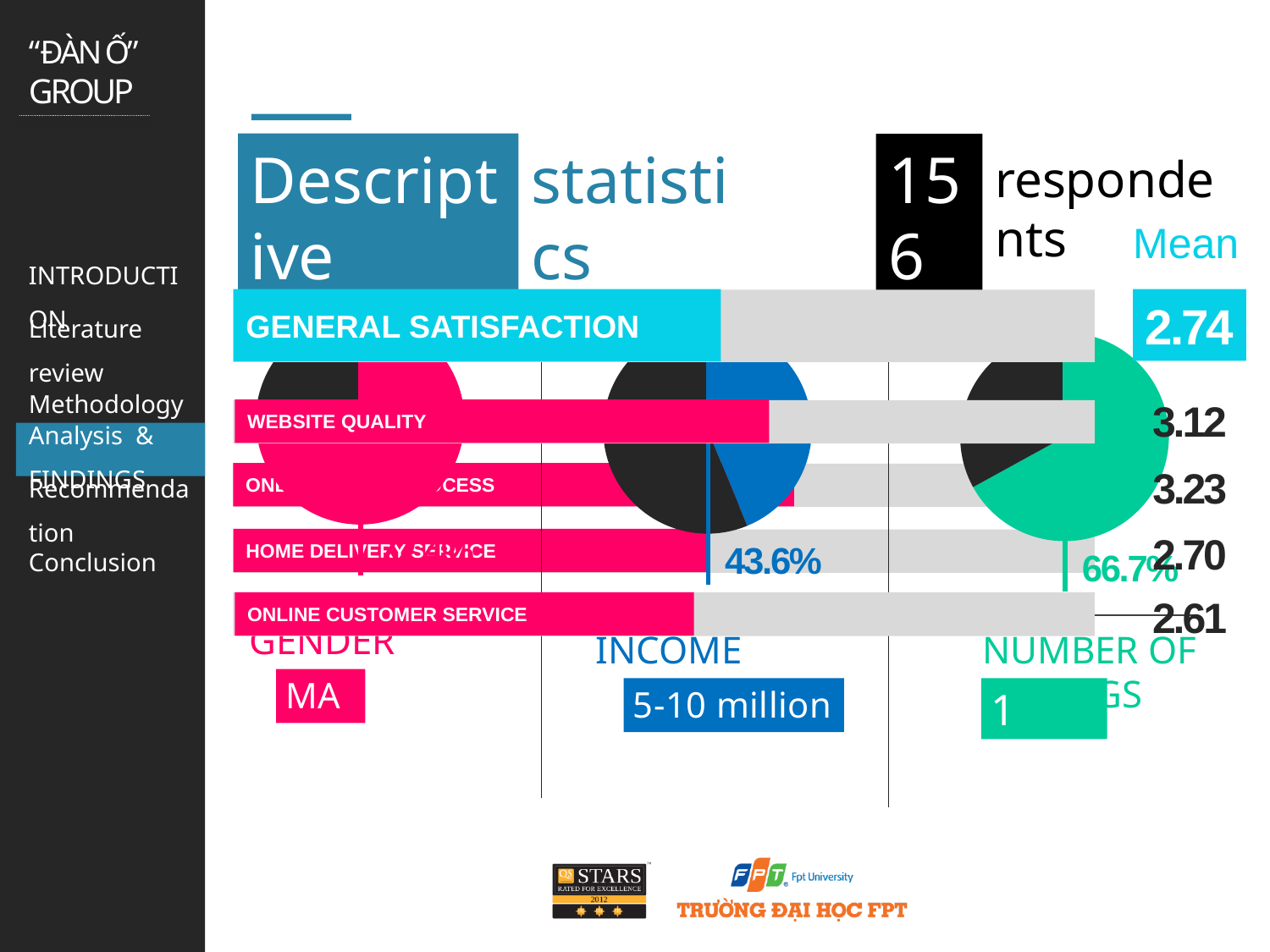
In the bar chart of mean scores, what is the difference between the means for HOME DELIVERY SERVICE and ONLINE CUSTOMER SERVICE? 0.09 How many categories are shown in the bar chart of mean scores? 5 In the bar chart of mean scores, what is the mean for GENERAL SATISFACTION? 2.74 In the bar chart of mean scores, what is the mean for WEBSITE QUALITY? 3.12 What kind of chart is used to show the mean scores? bar chart In the bar chart of mean scores, which category has the lowest mean? ONLINE CUSTOMER SERVICE In the bar chart of mean scores, what is the mean for ONLINE CUSTOMER SERVICE? 2.61 In the INCOME pie chart, what share is shown for the 5-10 million group? 43.6% In the bar chart of mean scores, what is the difference between the means for WEBSITE QUALITY and GENERAL SATISFACTION? 0.38 In the bar chart of mean scores, which has the higher mean, WEBSITE QUALITY or HOME DELIVERY SERVICE? WEBSITE QUALITY How many respondents does the slide report? 156 In the bar chart of mean scores, what is the mean for HOME DELIVERY SERVICE? 2.70